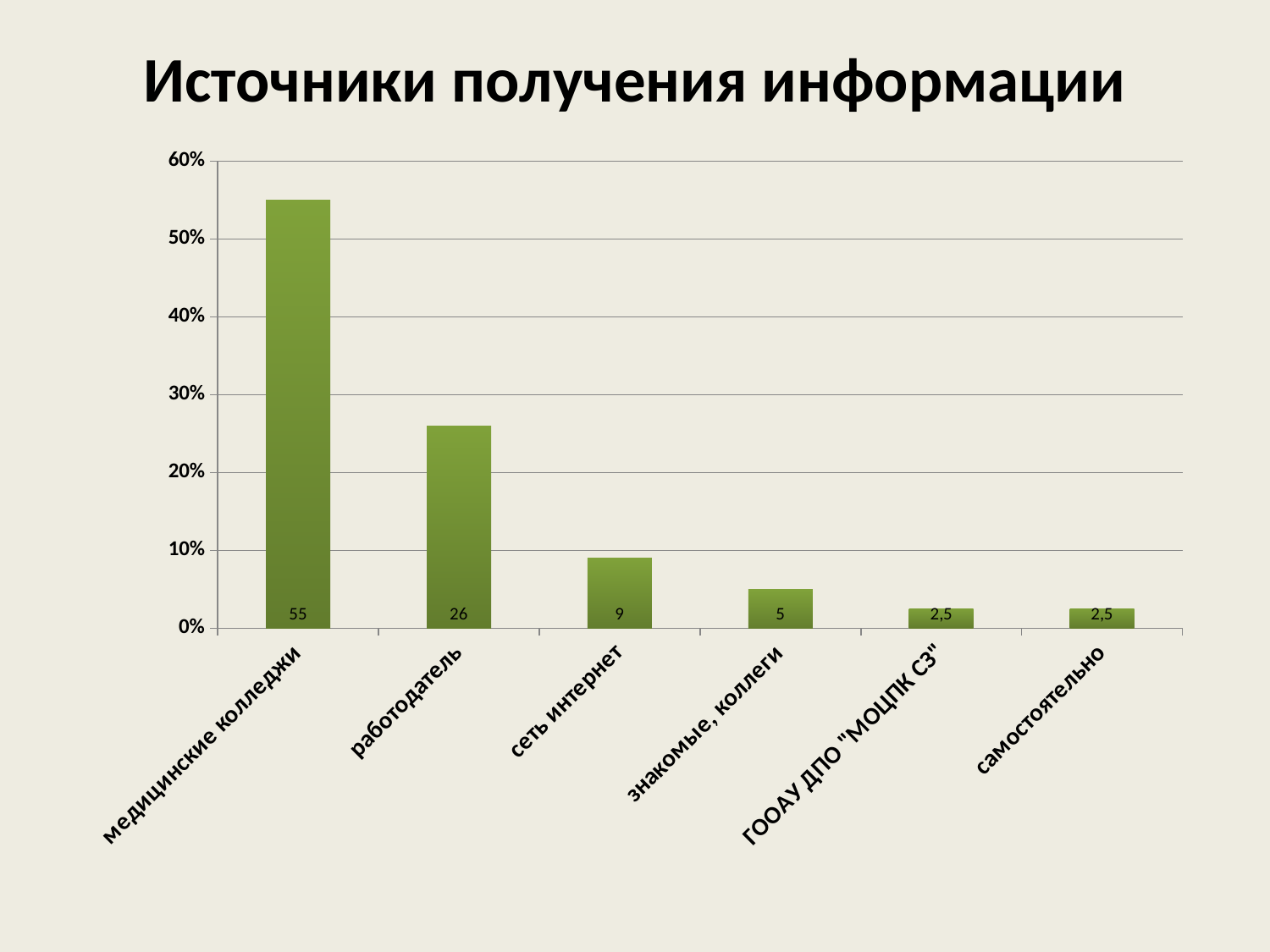
What kind of chart is shown on the slide? bar chart What is the value for работодатель? 26 What is the difference between the values for медицинские колледжи and работодатель? 29 How many categories are shown on the chart? 6 What is the value for медицинские колледжи? 55 Which category has the highest value? медицинские колледжи What is the value for самостоятельно? 2,5 Which is larger, the value for сеть интернет or the value for знакомые, коллеги? сеть интернет What is the value for сеть интернет? 9 What is the title of the slide? Источники получения информации Is the value for работодатель greater or less than 30%? less What is the value for знакомые, коллеги? 5